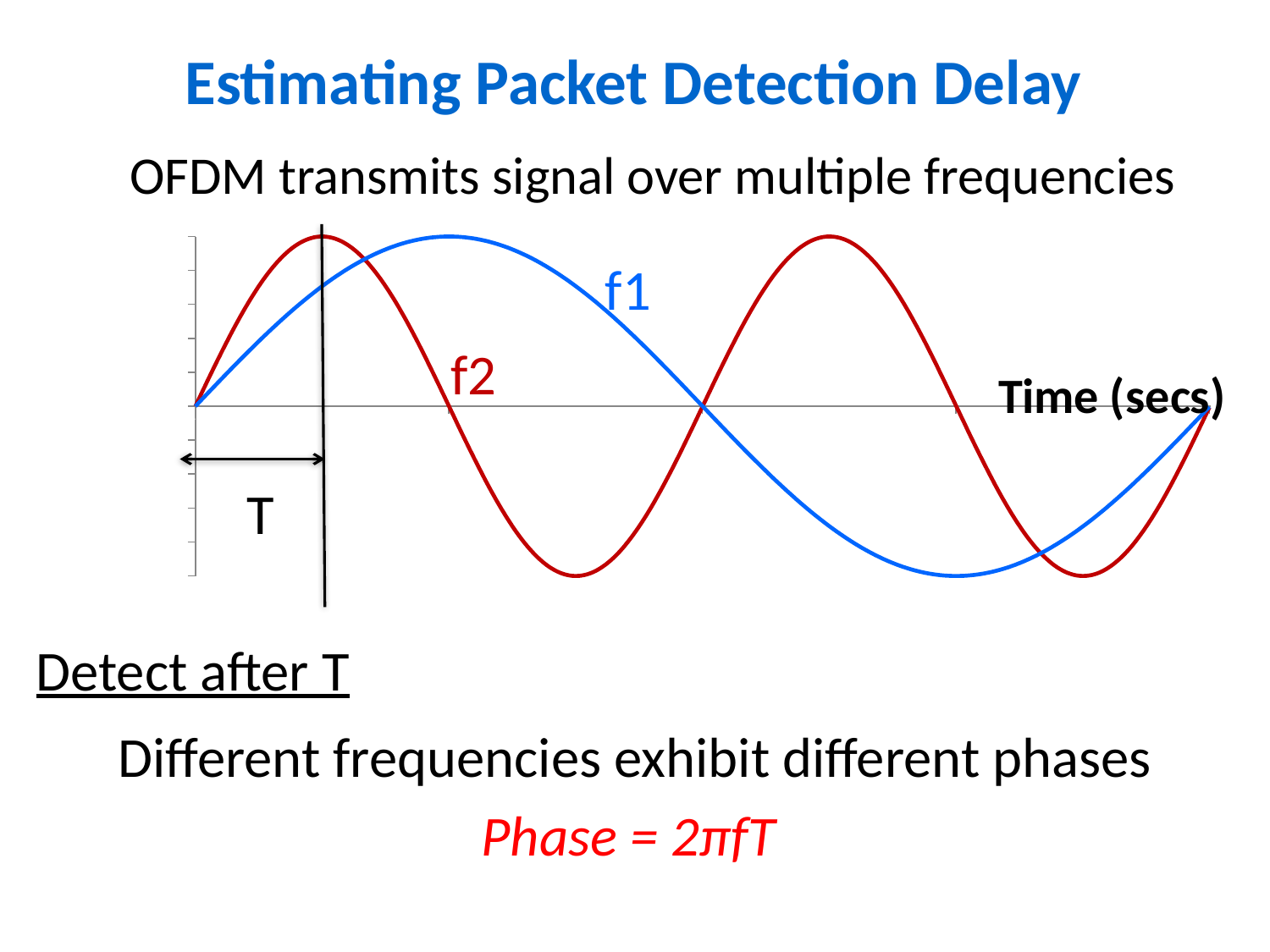
How many signal curves are plotted on the chart? 2 What are the labels of the two curves plotted on the chart? f1 and f2 What label is given to the time interval marked by the double-headed arrow from the start of the axis to the vertical line? T Which curve, f1 or f2, has the lower frequency? f1 What kind of chart is shown on the slide? Line chart Which curve, f1 or f2, reaches its first peak earlier in time? f2 Do both curves f1 and f2 start at the same value at time zero? Yes Which curve, f1 or f2, completes more full cycles over the plotted time range? f2